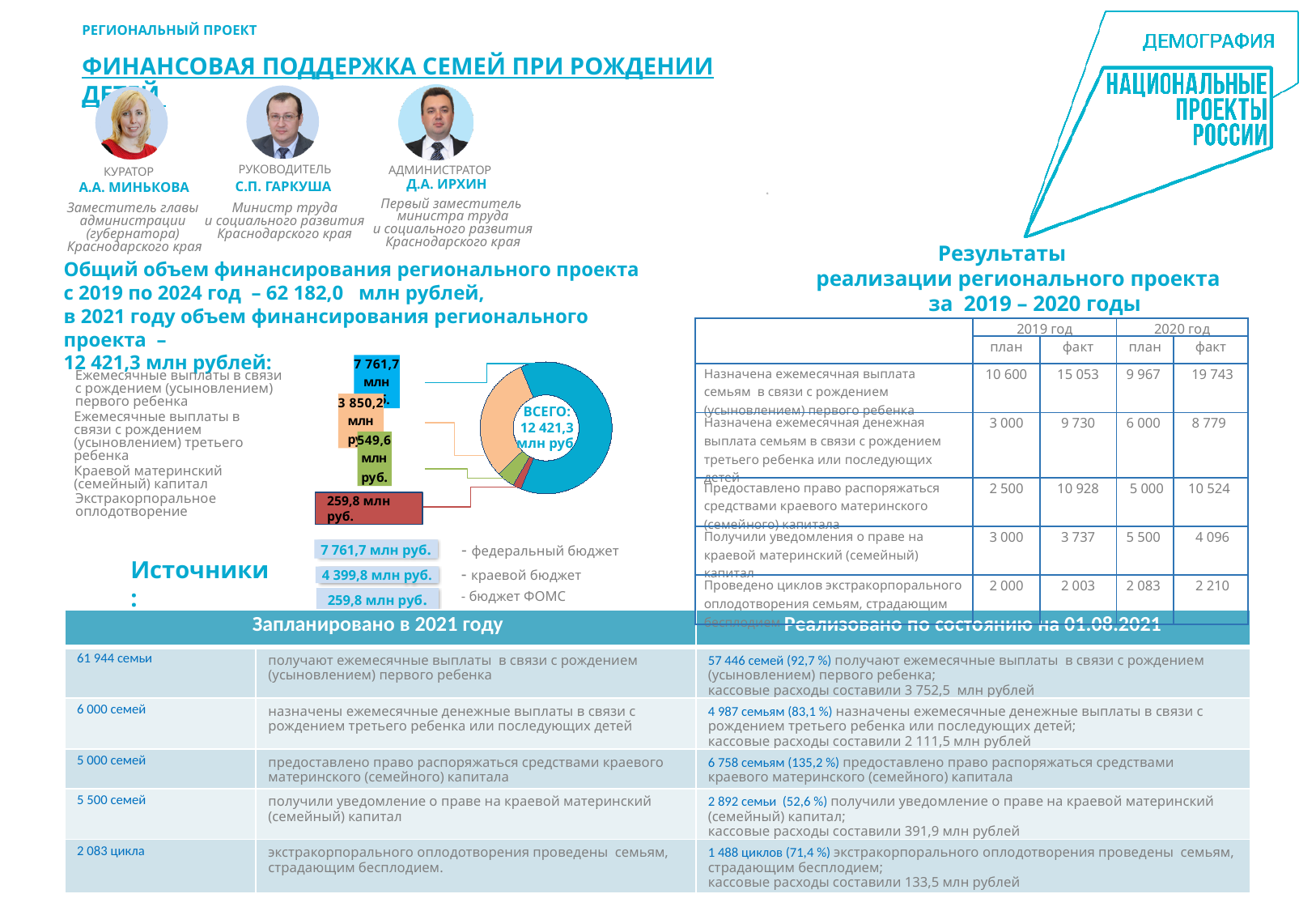
In the doughnut chart, what is the value for 'Ежемесячные выплаты в связи с рождением (усыновлением) первого ребенка'? 7 761,7 млн руб. Which category has the largest share in the doughnut chart? Ежемесячные выплаты в связи с рождением (усыновлением) первого ребенка In the doughnut chart, which is larger: 'Краевой материнский (семейный) капитал' or 'Экстракорпоральное оплодотворение'? Краевой материнский (семейный) капитал In the doughnut chart, what is the value for 'Экстракорпоральное оплодотворение'? 259,8 млн руб. What colour is the segment for 'Экстракорпоральное оплодотворение' in the doughnut chart? Red In the doughnut chart, what is the value for 'Ежемесячные выплаты в связи с рождением (усыновлением) третьего ребенка'? 3 850,2 млн руб. Which category has the smallest share in the doughnut chart? Экстракорпоральное оплодотворение What is the total shown in the centre of the doughnut chart? 12 421,3 млн руб. What kind of chart is used to show the 2021 funding breakdown of the regional project? Doughnut (pie) chart In the doughnut chart, what is the value for 'Краевой материнский (семейный) капитал'? 549,6 млн руб. How many categories does the doughnut chart show? 4 What is the difference between the payments for the first child (7 761,7 млн руб.) and the payments for the third child (3 850,2 млн руб.) in the doughnut chart? 3 911,5 млн руб.